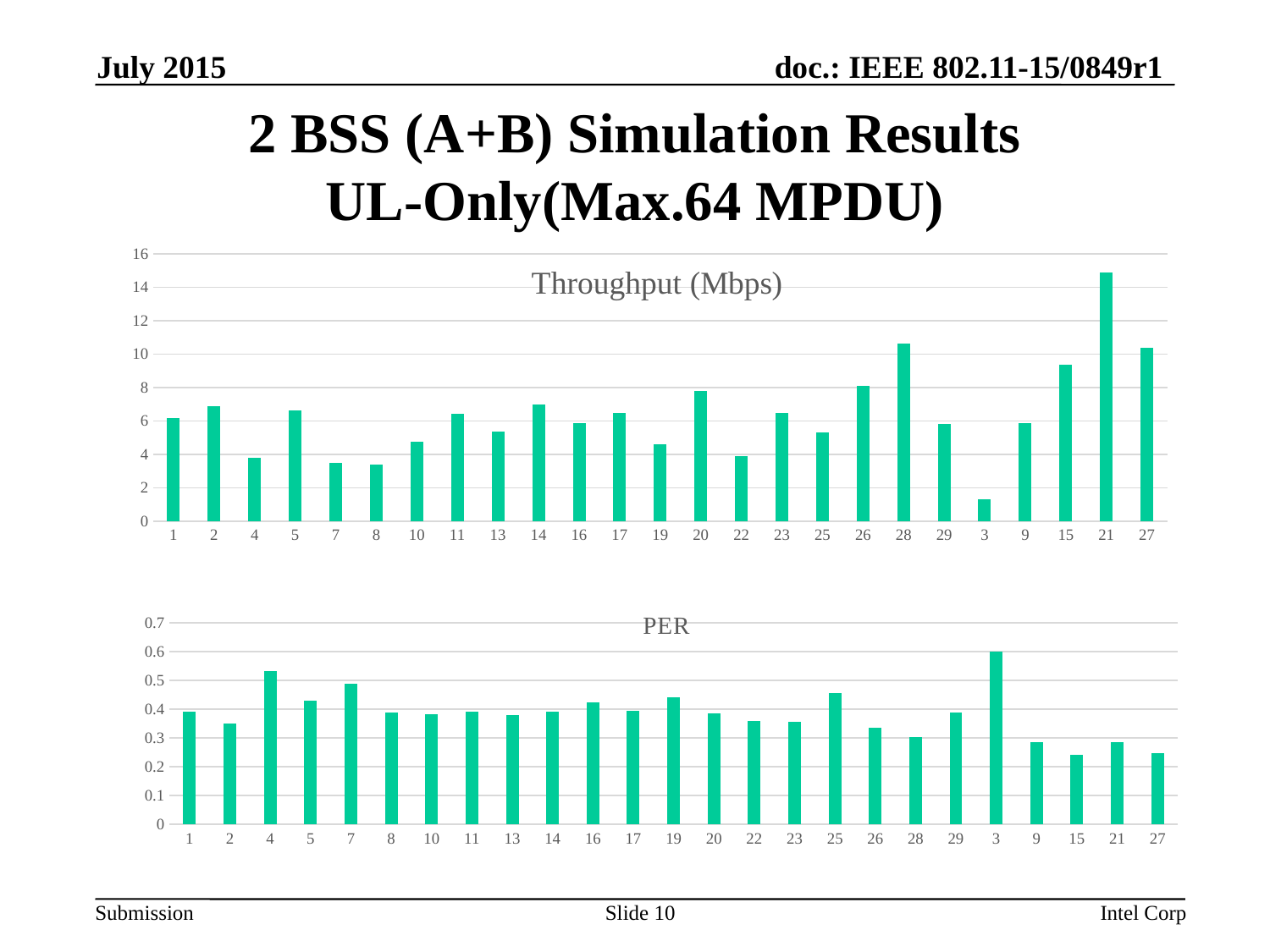
In the Throughput (Mbps) chart, which is larger, the value for category 21 or category 28? 21 In the Throughput (Mbps) chart, which category has the highest value? 21 In the PER chart, is the value for category 28 greater or less than 0.4? less In the PER chart, which category has the highest value? 3 In the Throughput (Mbps) chart, which category has the lowest value? 3 How many categories are shown on the x axis of the PER chart? 25 In the PER chart, is the value for category 4 greater or less than 0.5? greater What kind of chart is the Throughput (Mbps) chart? bar chart In the Throughput (Mbps) chart, is the value for category 21 greater or less than 14? greater In the PER chart, which is larger, the value for category 3 or category 15? 3 What is the title of the top chart on the slide? Throughput (Mbps)